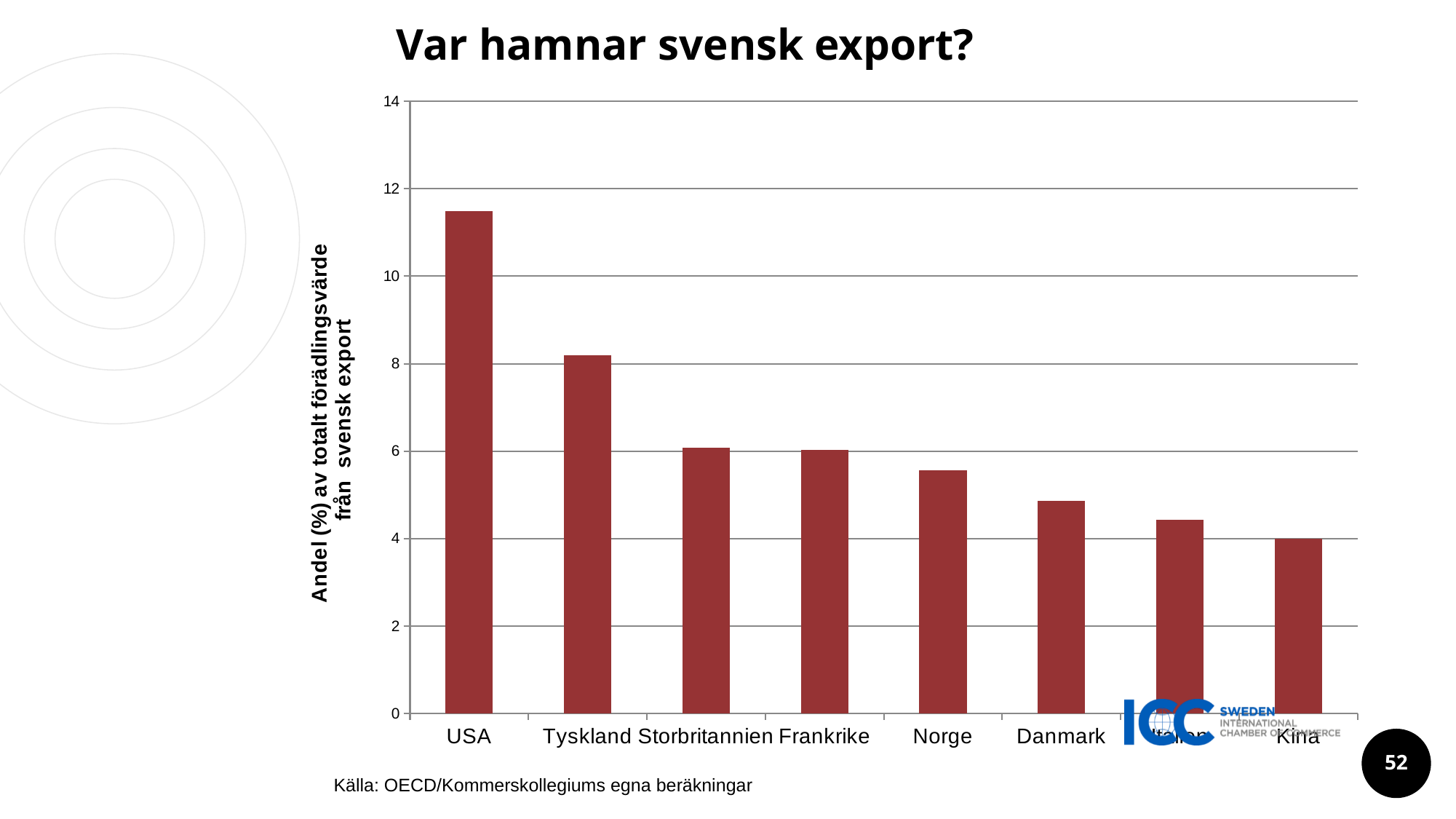
Which has a larger value, Norge or Danmark? Norge Is the value for Norge greater or less than 6? less What kind of chart is shown on the slide? bar chart Which has a larger value, USA or Tyskland? USA Is the value for Tyskland greater or less than 10? less Which country has the highest share of Swedish export value? USA Which country has the lowest share of Swedish export value? Kina What is the title of the chart? Var hamnar svensk export? Is the value for USA greater or less than 10? greater How many countries (bars) are shown in the chart? 8 Do the values rise or fall from left to right across the countries? fall